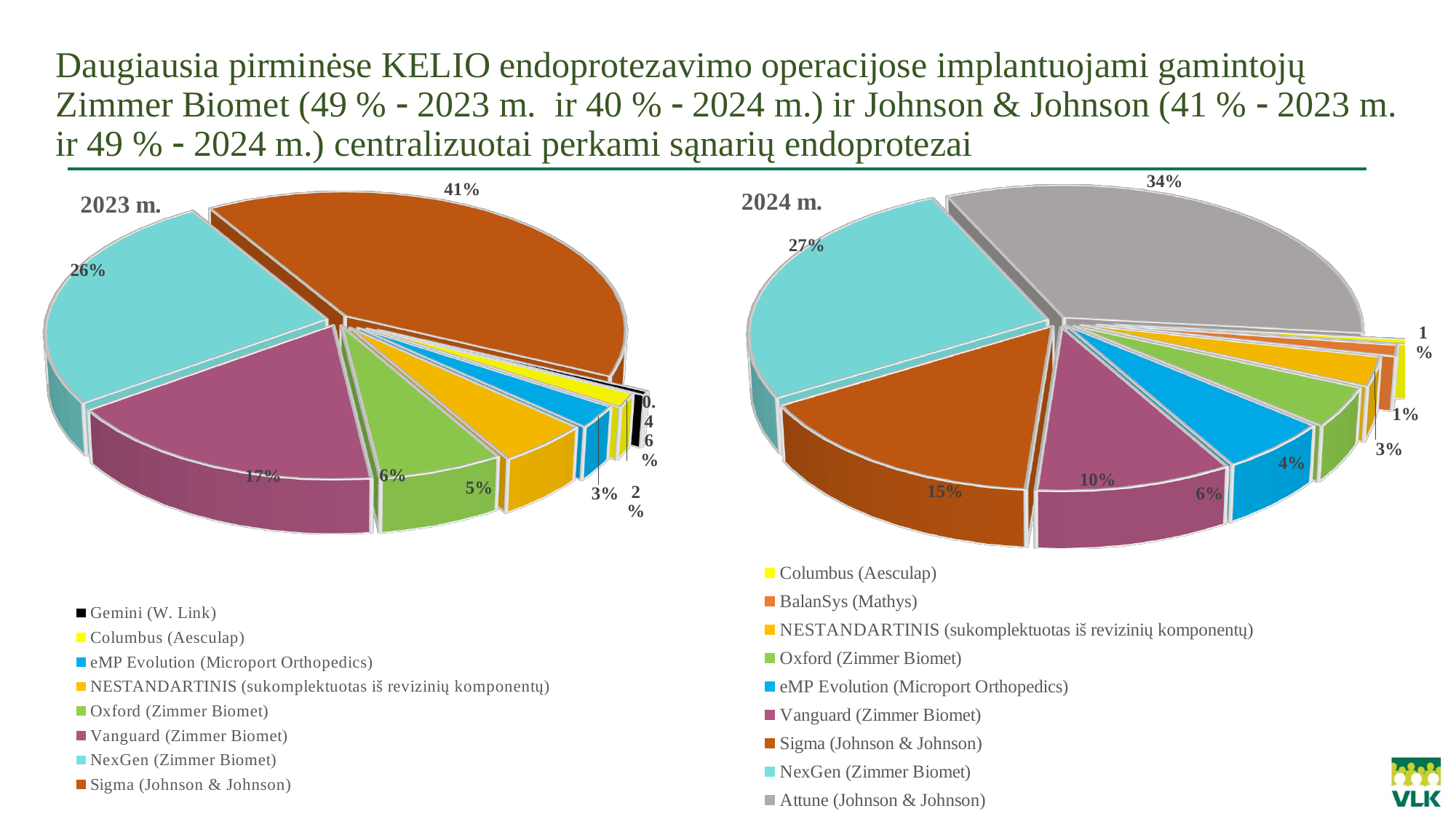
How many entries does the legend of the 2024 m. chart list? 9 In the 2024 m. chart, which is larger: the share of NexGen (Zimmer Biomet) or the share of Vanguard (Zimmer Biomet)? NexGen (Zimmer Biomet) In the 2023 m. chart, which manufacturer has the largest slice? Sigma (Johnson & Johnson) How many entries does the legend of the 2023 m. chart list? 8 In the 2024 m. chart, what share does Sigma (Johnson & Johnson) have? 15% In the 2023 m. chart, what is the difference between the shares of NexGen (Zimmer Biomet) and Vanguard (Zimmer Biomet)? 9% In the 2024 m. chart, what share does Attune (Johnson & Johnson) have? 34% In the 2024 m. chart, what is the difference between the shares of Attune (Johnson & Johnson) and NexGen (Zimmer Biomet)? 7% What type of charts are shown on the slide? Pie charts In the 2023 m. chart, which manufacturer has the smallest slice? Gemini (W. Link) In the 2023 m. chart, what share does NexGen (Zimmer Biomet) have? 26% In the 2023 m. chart, what share does Sigma (Johnson & Johnson) have? 41%